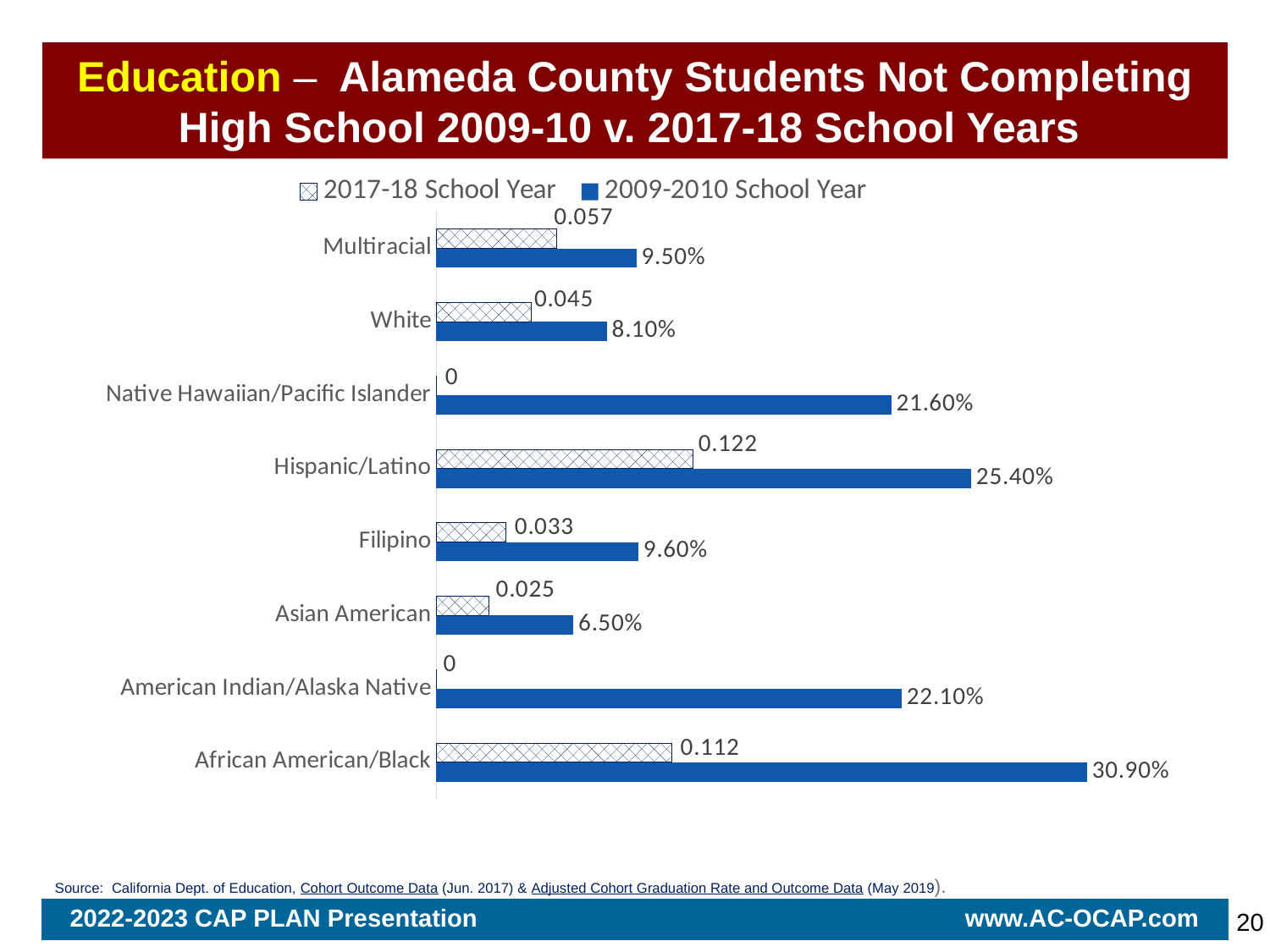
What is the 2017-18 School Year value for Hispanic/Latino? 0.122 How many series does the legend list? 2 What kind of chart is shown on the slide? Bar chart What is the difference between the 2009-2010 School Year values for Hispanic/Latino and White? 17.30% Which category has the highest 2009-2010 School Year value? African American/Black What is the 2009-2010 School Year value for Asian American? 6.50% How many categories are shown on the chart? 8 Which category has the highest 2017-18 School Year value? Hispanic/Latino Which is larger, the 2009-2010 School Year value for Filipino or for Multiracial? Filipino Which category has the lowest 2009-2010 School Year value? Asian American What is the 2017-18 School Year value for Native Hawaiian/Pacific Islander? 0 What is the 2009-2010 School Year value for African American/Black? 30.90%